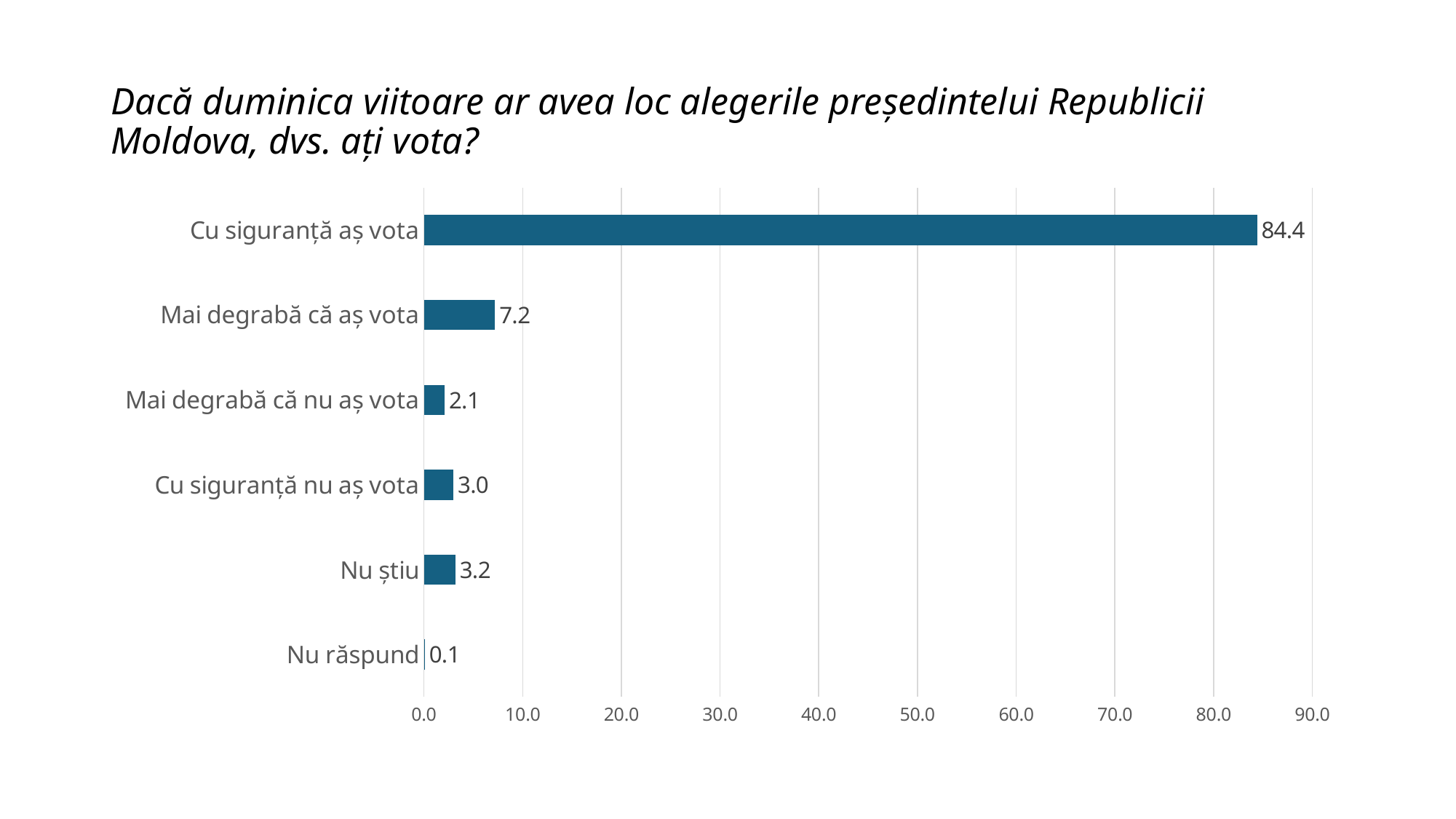
What is the value for "Nu răspund"? 0.1 How many categories are shown in the chart? 6 Which category has the lowest value? Nu răspund What kind of chart is shown on the slide? Bar chart What is the difference between the values for "Cu siguranță aș vota" and "Mai degrabă că aș vota"? 77.2 Is the value for "Cu siguranță aș vota" greater or less than 80.0? greater What is the value for "Mai degrabă că aș vota"? 7.2 Which is larger, the value for "Mai degrabă că nu aș vota" or the value for "Cu siguranță nu aș vota"? Cu siguranță nu aș vota What is the value for "Cu siguranță aș vota"? 84.4 What is the value for "Nu știu"? 3.2 Which category has the highest value? Cu siguranță aș vota What is the difference between the values for "Nu știu" and "Cu siguranță nu aș vota"? 0.2